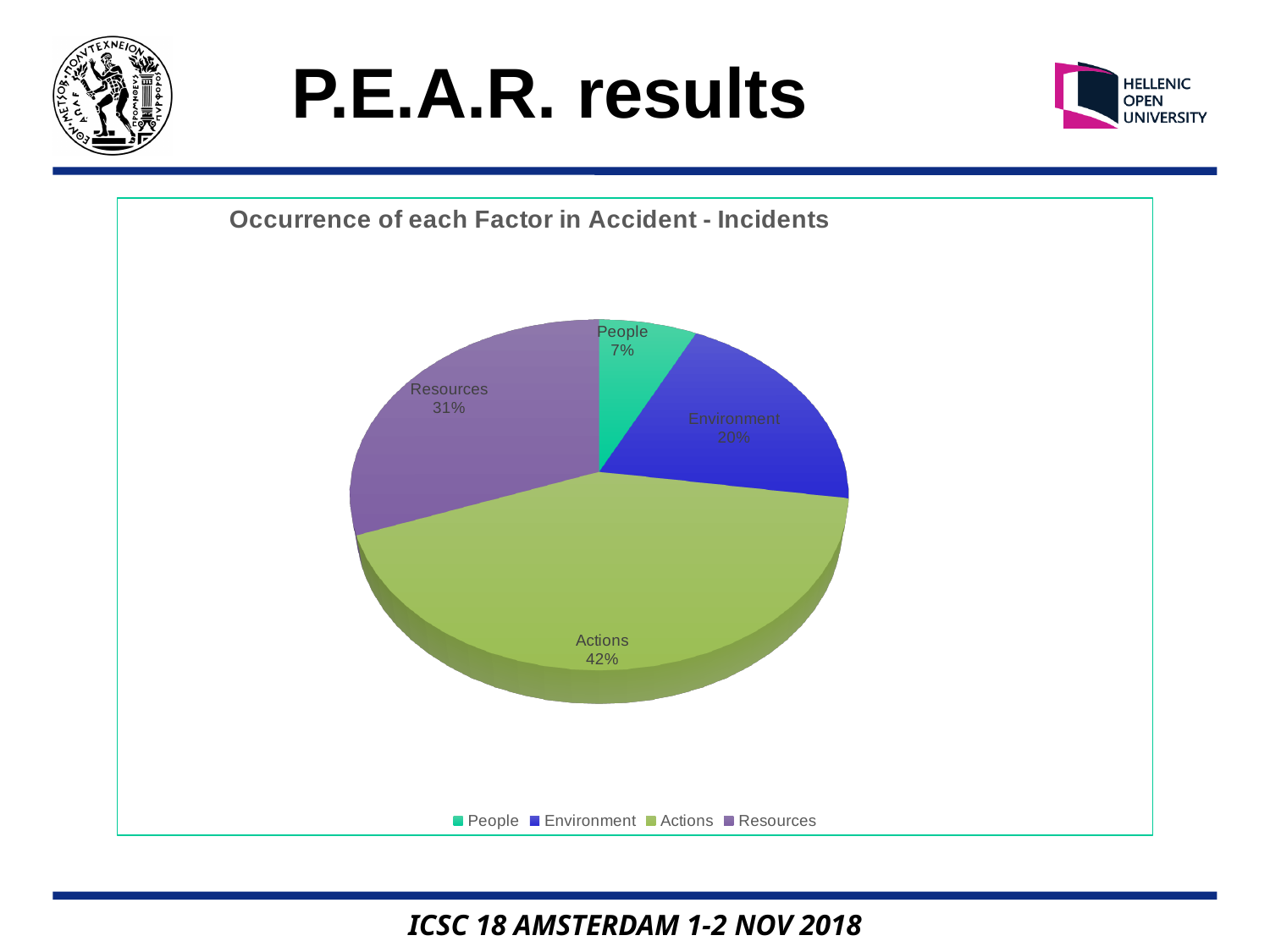
Which factor has the largest share of the pie? Actions How many slices does the pie chart have? 4 What share of the pie does People represent? 7% What share of the pie does Environment represent? 20% What share of the pie does Actions represent? 42% What is the title of the chart? Occurrence of each Factor in Accident - Incidents What is the difference in percentage points between Actions and Resources? 11 How many entries does the legend list? 4 What type of chart is shown on the slide? pie chart Which has a larger share, Environment or Resources? Resources Which factor has the smallest share of the pie? People